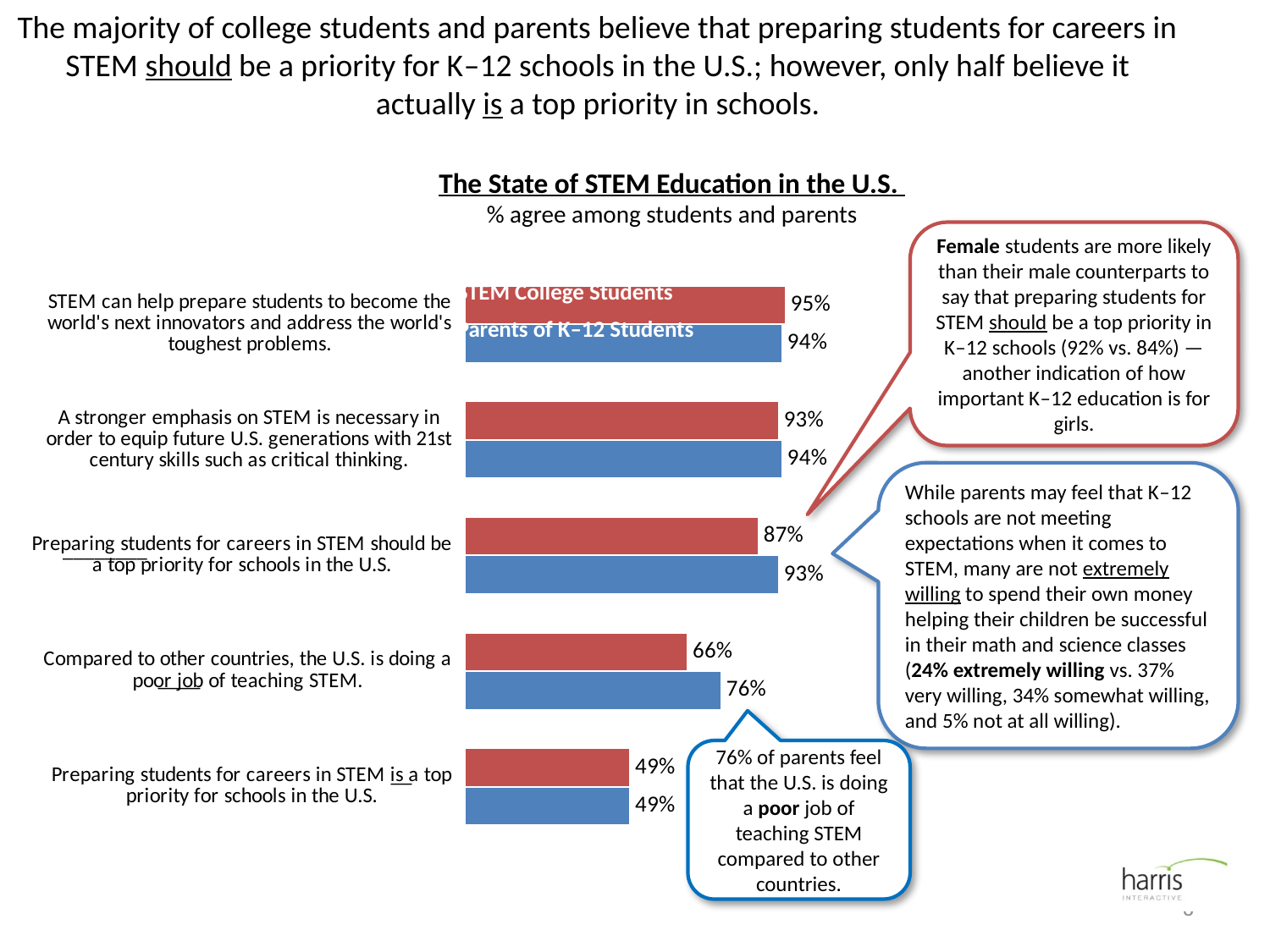
For the statement that preparing students for careers in STEM should be a top priority, which group has the higher agreement: STEM College Students or Parents of K–12 Students? Parents of K–12 Students What percentage of Parents of K–12 Students agree that a stronger emphasis on STEM is necessary to equip future U.S. generations with 21st century skills? 94% Which statement has the highest agreement among STEM College Students? STEM can help prepare students to become the world's next innovators and address the world's toughest problems. What is the subtitle shown under the chart title 'The State of STEM Education in the U.S.'? % agree among students and parents What percentage of Parents of K–12 Students agree that, compared to other countries, the U.S. is doing a poor job of teaching STEM? 76% Which statement has the lowest agreement among Parents of K–12 Students? Preparing students for careers in STEM is a top priority for schools in the U.S. What percentage of STEM College Students agree that STEM can help prepare students to become the world's next innovators? 95% How many statements (categories) are plotted in the chart? 5 What is the difference between Parents of K–12 Students and STEM College Students on the statement that the U.S. is doing a poor job of teaching STEM compared to other countries? 10% What kind of chart is shown on the slide? Bar chart How many series does the chart's legend list? 2 What percentage of STEM College Students agree that preparing students for careers in STEM should be a top priority for schools in the U.S.? 87%